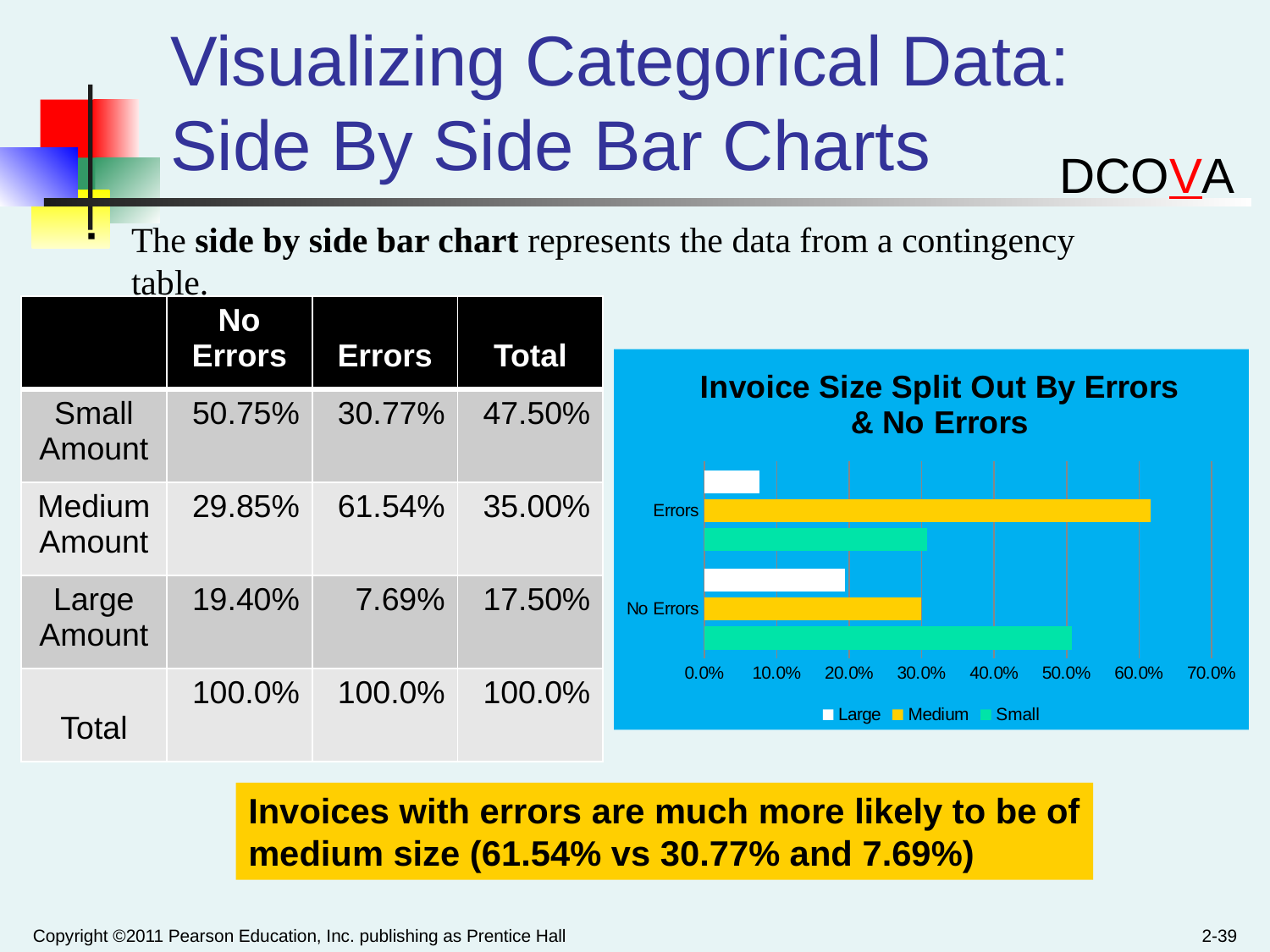
What is the title of the chart? Invoice Size Split Out By Errors & No Errors Is the Large bar for Errors greater or less than 10.0%? less Is the Medium bar for Errors greater or less than 50.0%? greater How many categories are shown on the vertical axis of the chart? 2 In the chart, which invoice size has the shortest bar for Errors? Large What kind of chart is shown on the slide? bar chart Which is larger in the chart: the Small bar for Errors or the Small bar for No Errors? Small bar for No Errors In the chart, which invoice size has the longest bar for Errors? Medium Which series is shown in yellow in the chart? Medium How many series does the chart legend list? 3 In the chart, which invoice size has the shortest bar for No Errors? Large In the chart, which invoice size has the longest bar for No Errors? Small